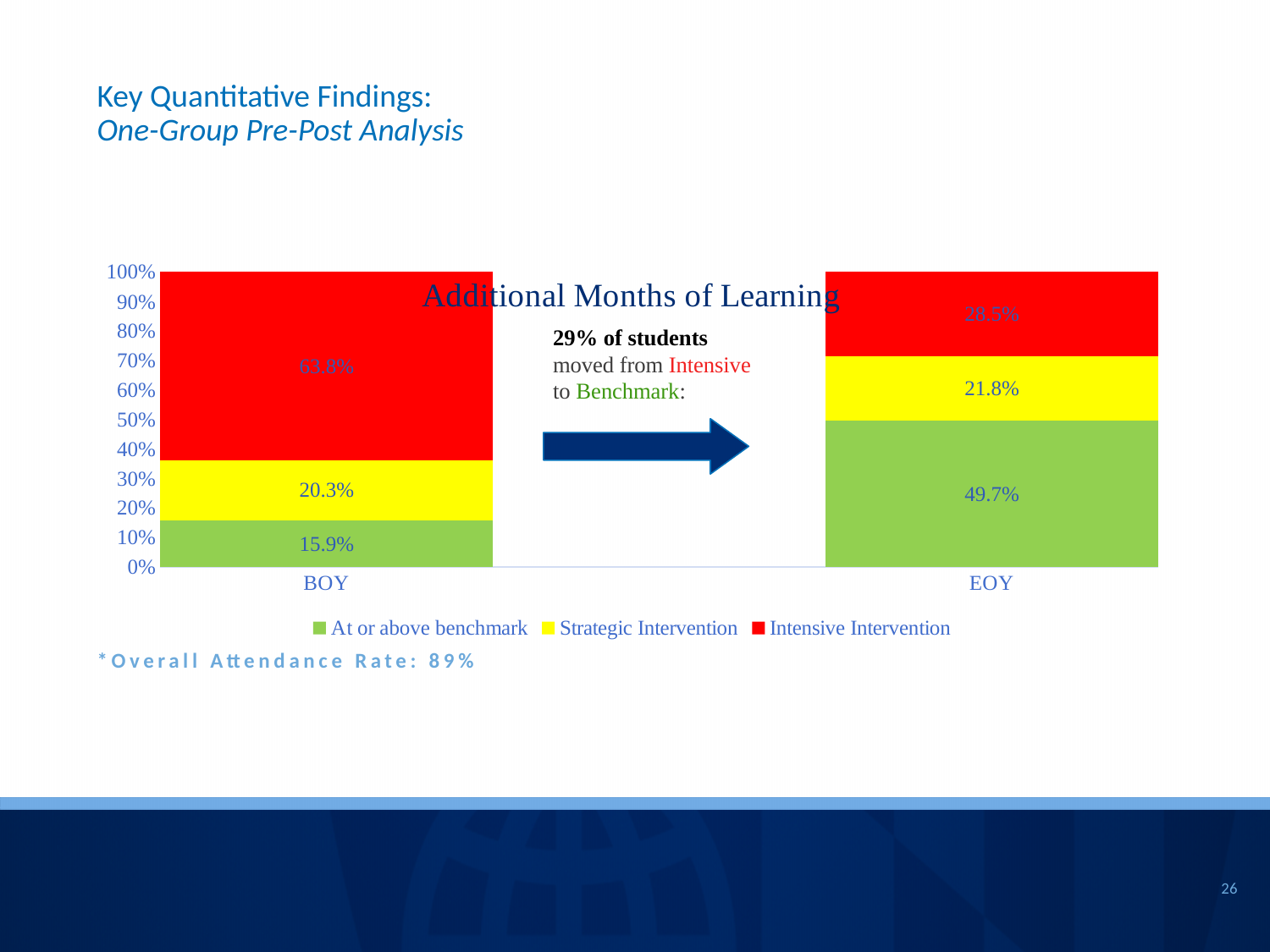
What is the value for At or above benchmark at EOY? 49.7% How many series does the legend list? 3 What is the value for Intensive Intervention at BOY? 63.8% What is the value for Strategic Intervention at EOY? 21.8% What is the value for Intensive Intervention at EOY? 28.5% What kind of chart is shown on the slide? Stacked bar chart Which colour represents Strategic Intervention in the legend? Yellow Which is larger, the Intensive Intervention value at BOY or at EOY? BOY What is the difference between the At or above benchmark values at EOY and BOY? 33.8% What is the value for At or above benchmark at BOY? 15.9% Does the At or above benchmark value rise or fall from BOY to EOY? Rise How many categories are shown on the x axis? 2